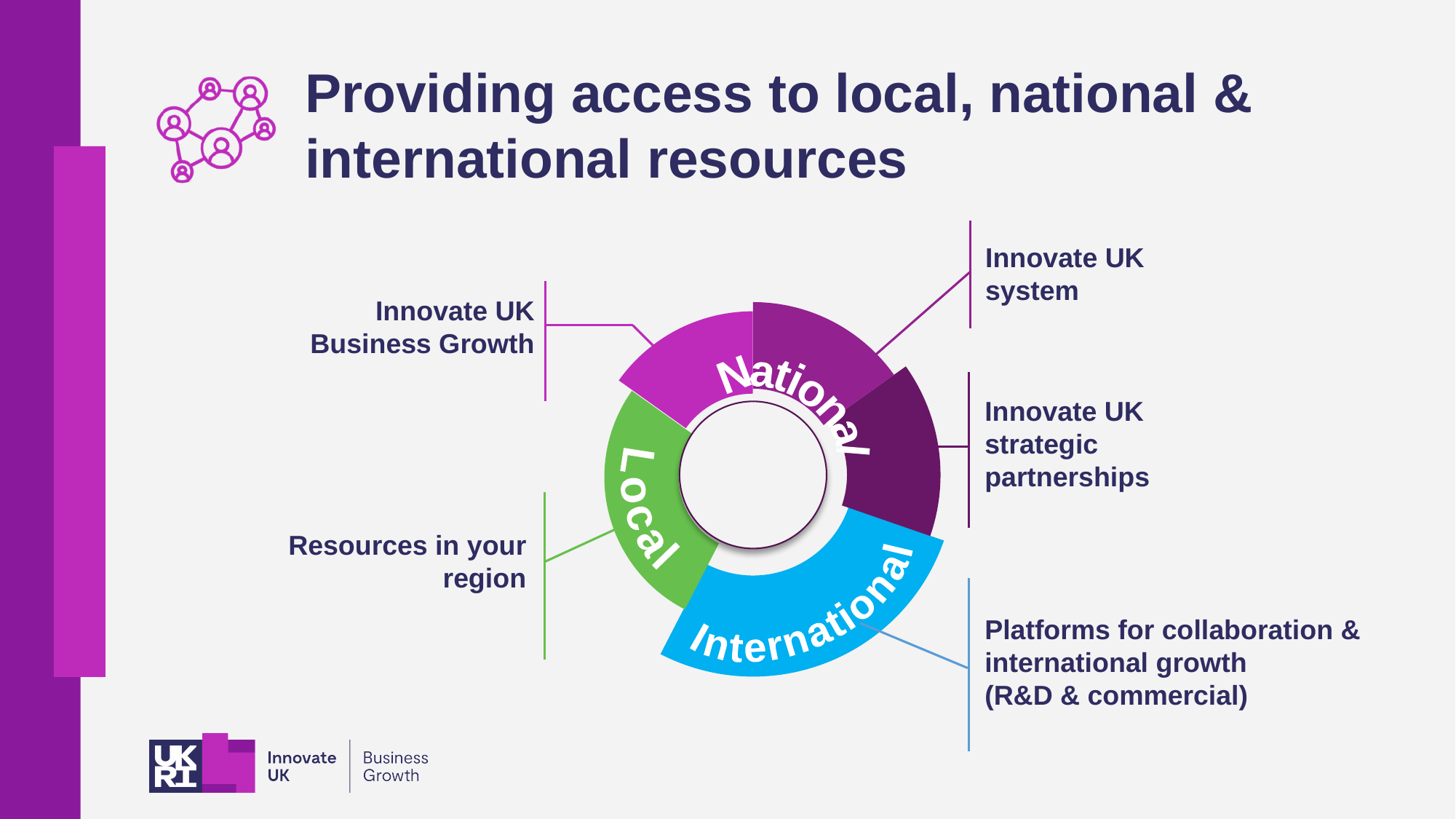
Which callout is connected to the magenta segment on the upper left of the ring? Innovate UK Business Growth Which callout text is connected to the green 'Local' segment? Resources in your region Which callout is connected to the darkest purple segment of the ring? Innovate UK strategic partnerships How many separate segments make up the ring? 5 Which callout text is connected to the blue 'International' segment? Platforms for collaboration & international growth (R&D & commercial) How many callouts are attached to the 'National' part of the ring? 3 Which ring label is written on the blue segment? International Which ring label is written on the green segment? Local How many main groups (ring labels) are written on the ring? 3 What kind of chart is shown on the slide? Donut (ring) chart